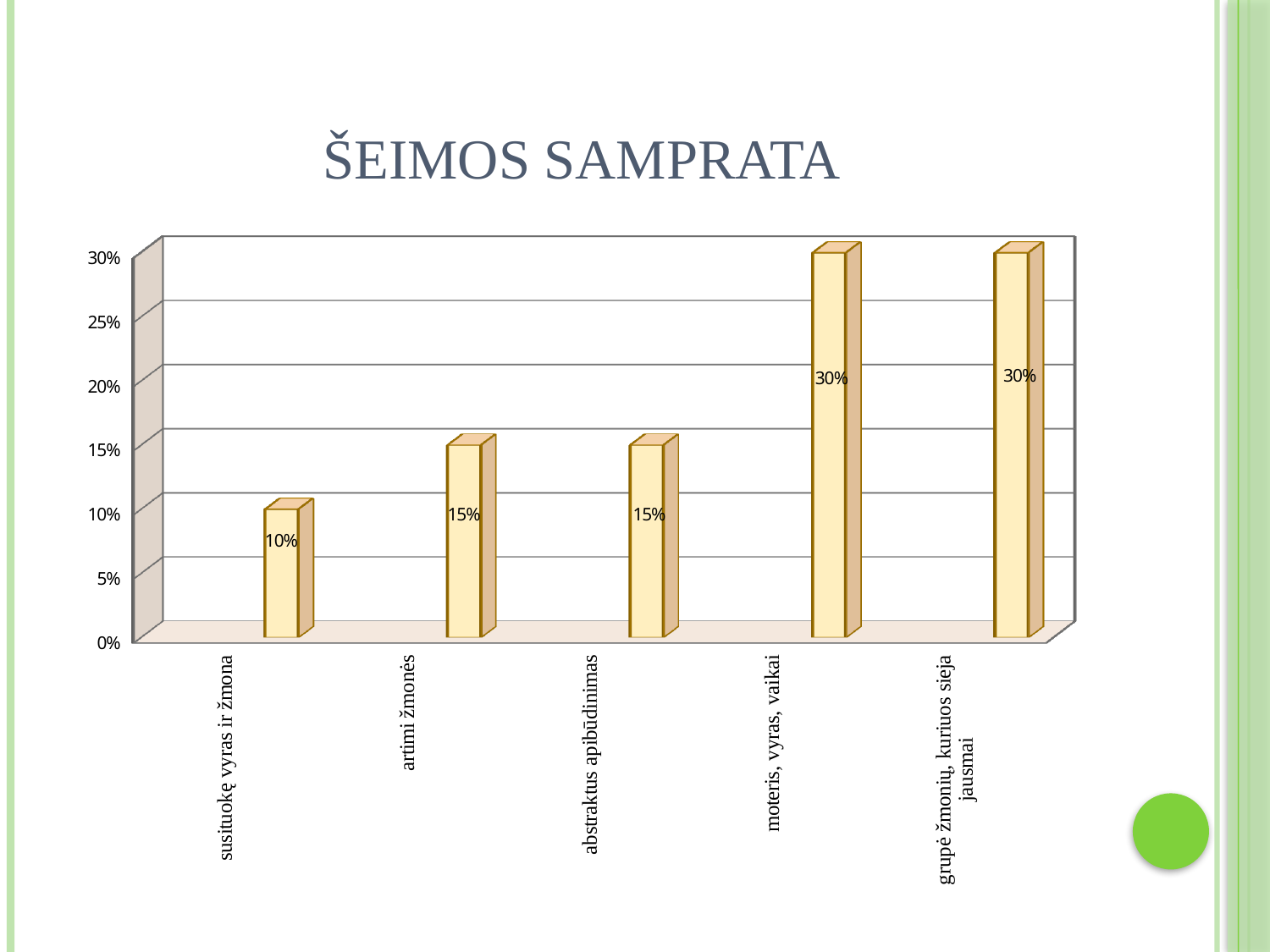
Which category has the lowest value? susituokę vyras ir žmona Is the value for "grupė žmonių, kuriuos sieja jausmai" greater or less than 20%? greater What is the value for "moteris, vyras, vaikai"? 30% What is the value for "susituokę vyras ir žmona"? 10% What is the value for "abstraktus apibūdinimas"? 15% How many categories are shown in the chart? 5 What type of chart is shown on the slide? bar chart What is the difference between the values for "moteris, vyras, vaikai" and "susituokę vyras ir žmona"? 20% What is the difference between the values for "artimi žmonės" and "susituokę vyras ir žmona"? 5% Which is larger, the value for "moteris, vyras, vaikai" or the value for "abstraktus apibūdinimas"? moteris, vyras, vaikai What is the value for "grupė žmonių, kuriuos sieja jausmai"? 30% What is the value for "artimi žmonės"? 15%